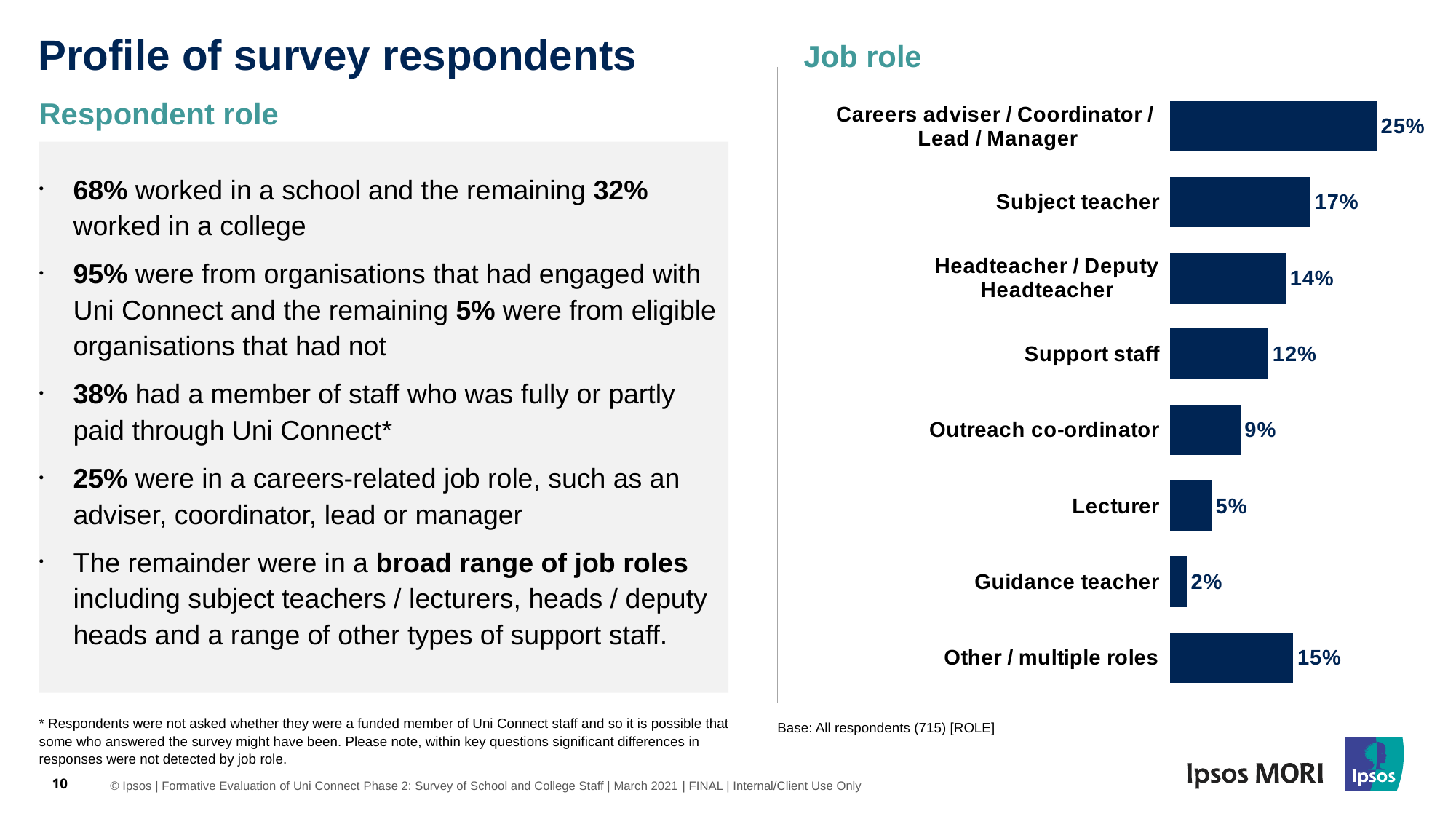
Which is larger: the percentage for Outreach co-ordinator or for Support staff? Support staff Which is larger: the percentage for Other / multiple roles or for Headteacher / Deputy Headteacher? Other / multiple roles What is the title of the chart on the right of the slide? Job role What type of chart is used to show the Job role data? Bar chart What is the value shown for Support staff in the Job role chart? 12% Which job role has the lowest percentage in the chart? Guidance teacher Which job role has the highest percentage in the chart? Careers adviser / Coordinator / Lead / Manager What percentage of respondents were Subject teachers according to the Job role chart? 17% What is the difference in percentage points between Careers adviser / Coordinator / Lead / Manager and Subject teacher? 8 What percentage of respondents were Lecturers? 5% How many job role categories are shown in the chart? 8 What is the difference in percentage points between Other / multiple roles and Headteacher / Deputy Headteacher? 1